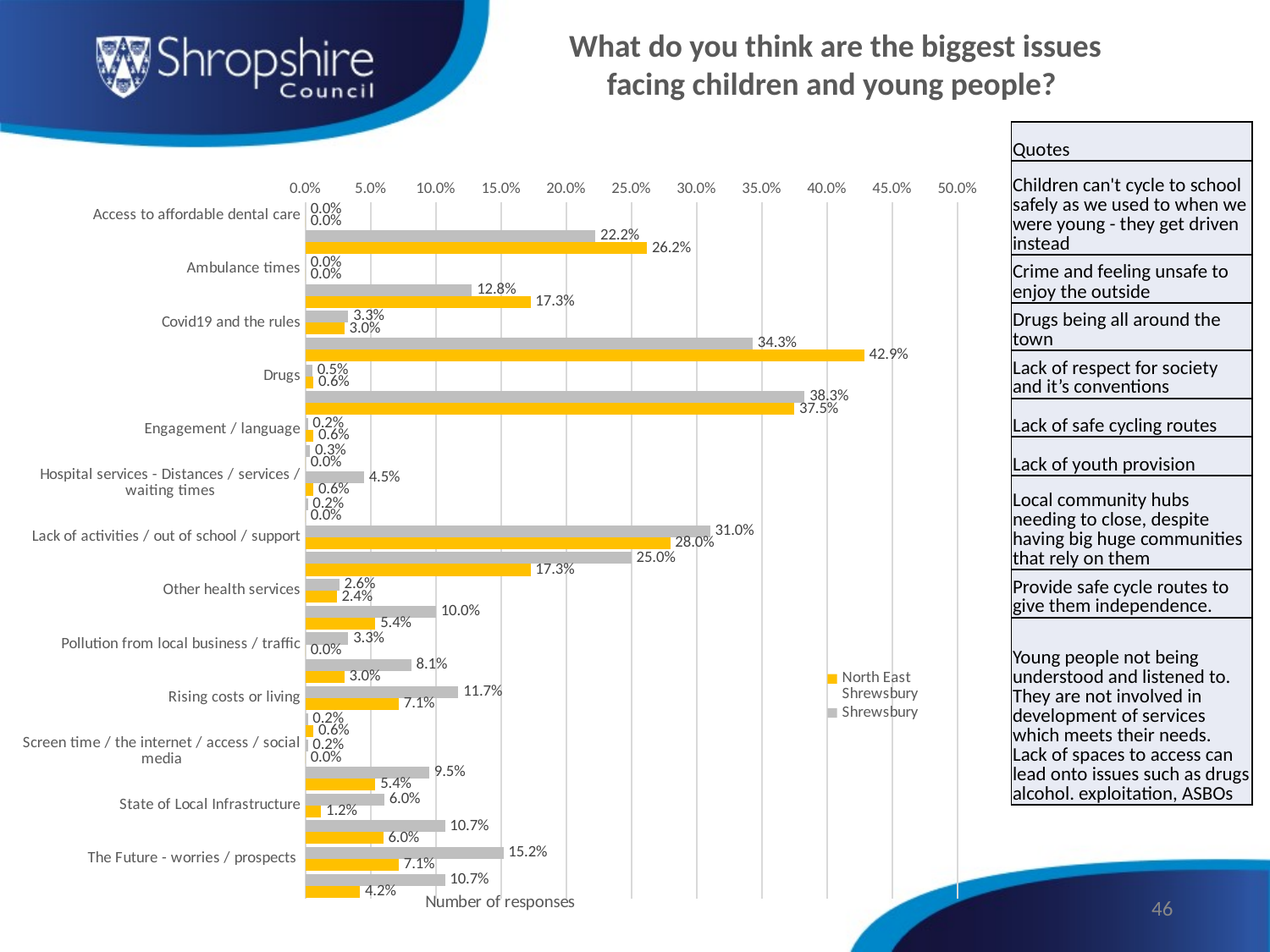
What is the highest value shown for the Shrewsbury series? 38.3% How many series does the chart's legend list? 2 What is the highest value shown for the North East Shrewsbury series? 42.9% What is the maximum tick value shown on the chart's horizontal axis? 50.0% For Lack of activities / out of school / support, what is the difference between the Shrewsbury value (31.0%) and the North East Shrewsbury value (28.0%)? 3.0 percentage points Which series has the larger single highest value, North East Shrewsbury or Shrewsbury? North East Shrewsbury What is the Shrewsbury value for Covid19 and the rules? 3.3% What is the Shrewsbury value for Rising costs or living? 11.7% What type of chart is shown on the slide? Bar chart What is the North East Shrewsbury value for Lack of activities / out of school / support? 28.0% What are the two series named in the chart's legend? North East Shrewsbury and Shrewsbury What is the title of the slide containing the chart? What do you think are the biggest issues facing children and young people?